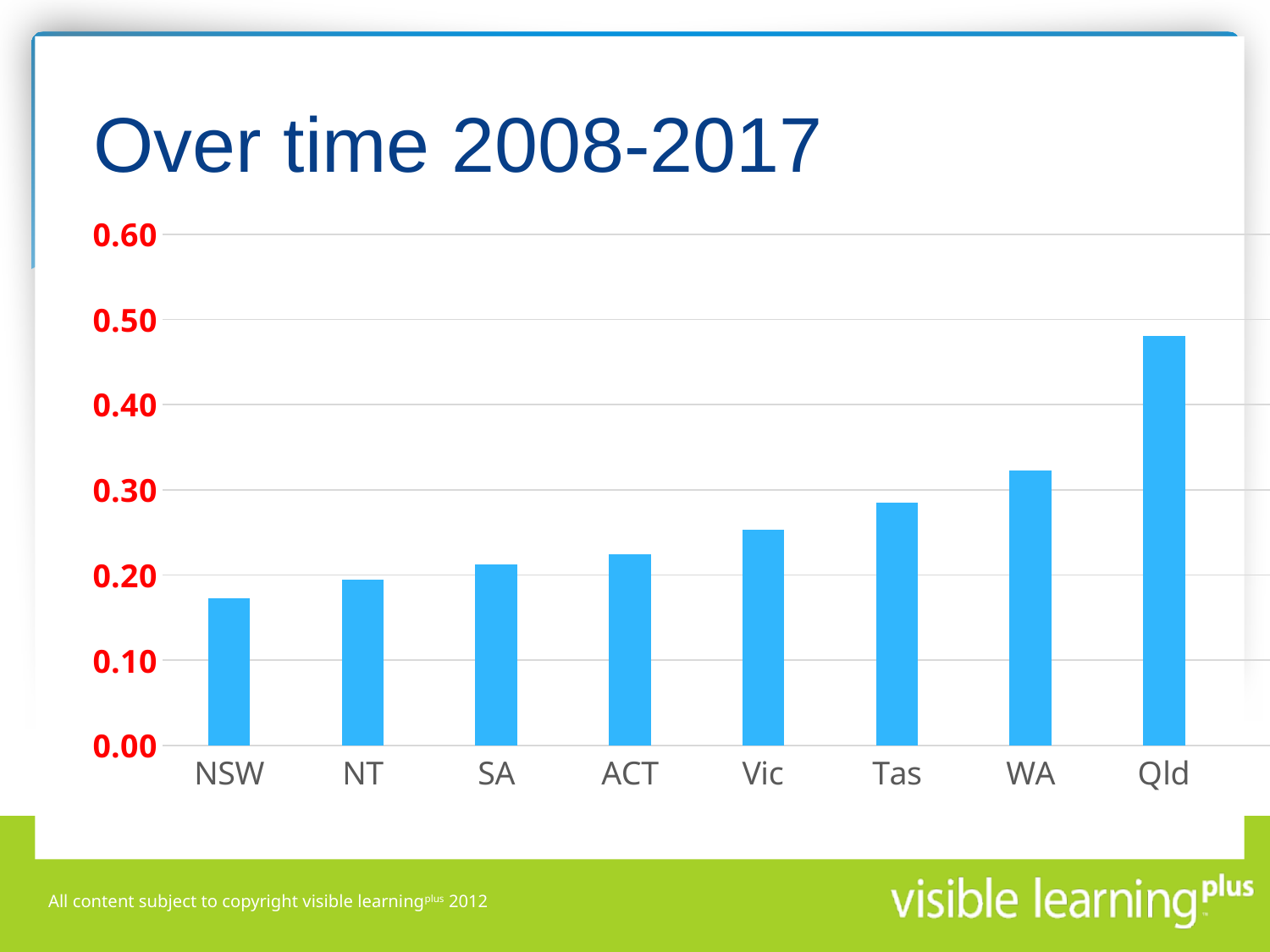
How many categories are shown on the x axis of the chart? 8 Do the values rise or fall moving from NSW to Qld along the x axis? rise Is the value for Qld greater or less than 0.50? less Which category has the lowest value in the chart? NSW What kind of chart is shown on the slide? bar chart Which category has the highest value in the chart? Qld Which has the larger value, Tas or NT? Tas Is the value for NSW greater or less than 0.20? less What is the title of the chart on the slide? Over time 2008-2017 Is the value for Qld greater or less than 0.40? greater